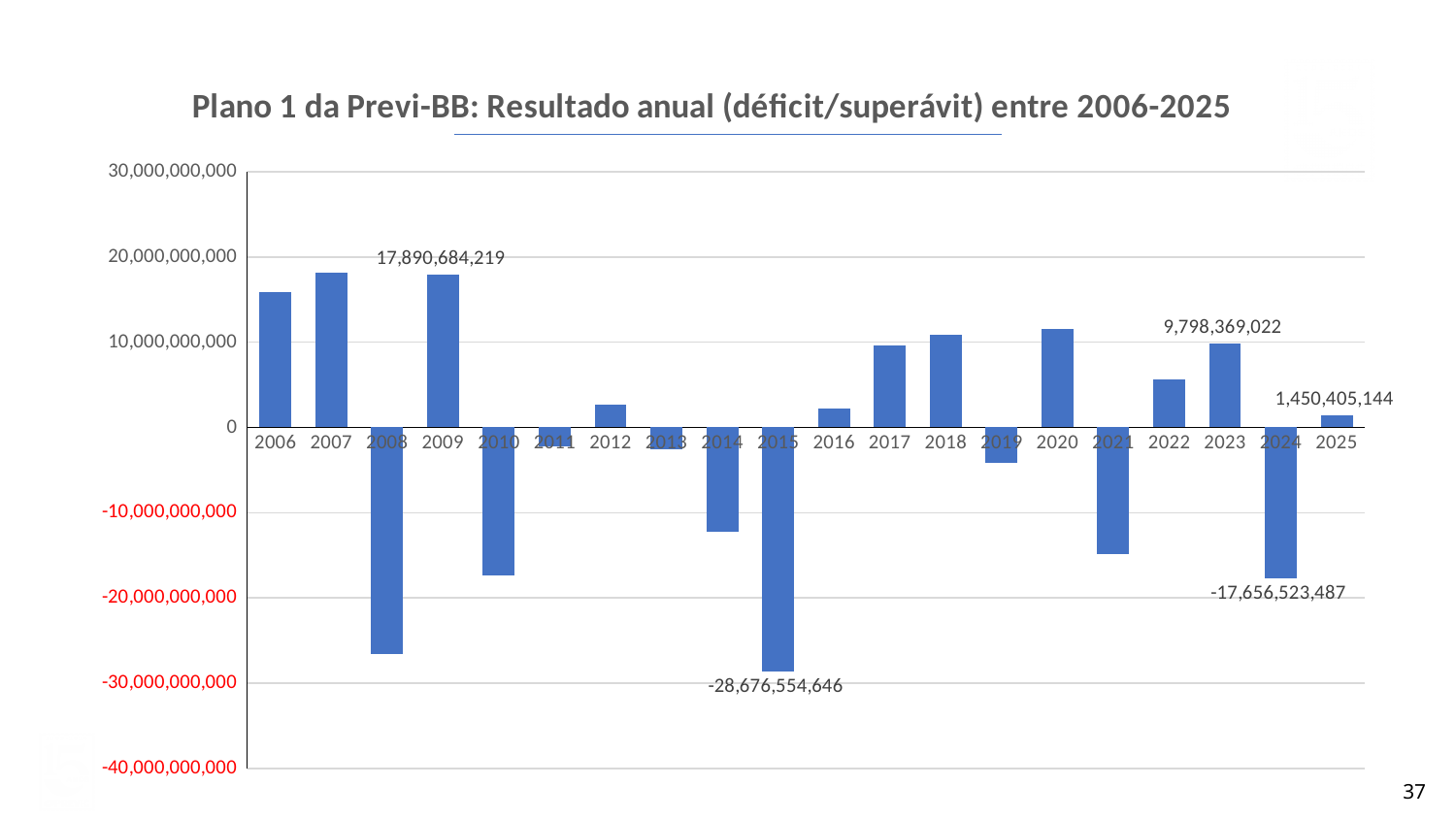
Which is larger, the value for 2009 or the value for 2023? 2009 Is the value for 2020 greater or less than 10,000,000,000? greater What is the value for 2024? -17,656,523,487 What is the value for 2009? 17,890,684,219 What is the difference between the values for 2023 and 2025? 8,347,963,878 What kind of chart is shown on the slide? bar chart What is the value for 2023? 9,798,369,022 Is the value for 2008 greater or less than -20,000,000,000? less What is the value for 2015? -28,676,554,646 Which year has the lowest value? 2015 What is the value for 2025? 1,450,405,144 How many years are shown on the x axis? 20